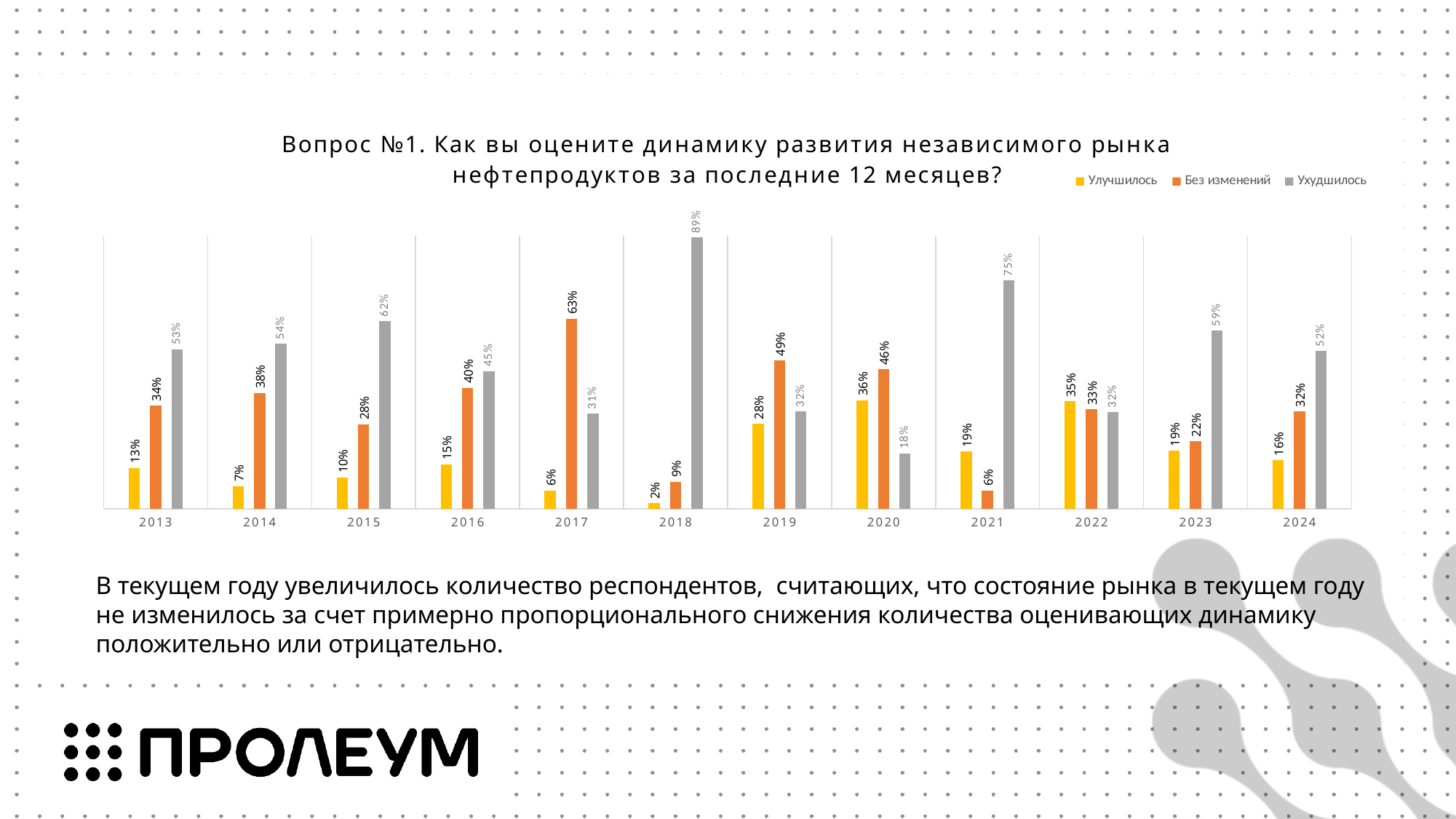
Which is larger in 2017: Без изменений or Ухудшилось? Без изменений How many years are shown on the x axis? 12 What is the value for Без изменений in 2024? 32% How many series does the legend list? 3 Which series is shown in grey in the legend? Ухудшилось What is the value for Ухудшилось in 2018? 89% What is the difference between the Ухудшилось value in 2021 and in 2022? 43% What is the value for Улучшилось in 2020? 36% What is the total of the three values for 2022? 100% In which year is the Ухудшилось value highest? 2018 In which year is the Улучшилось value lowest? 2018 What type of chart is shown on the slide? bar chart